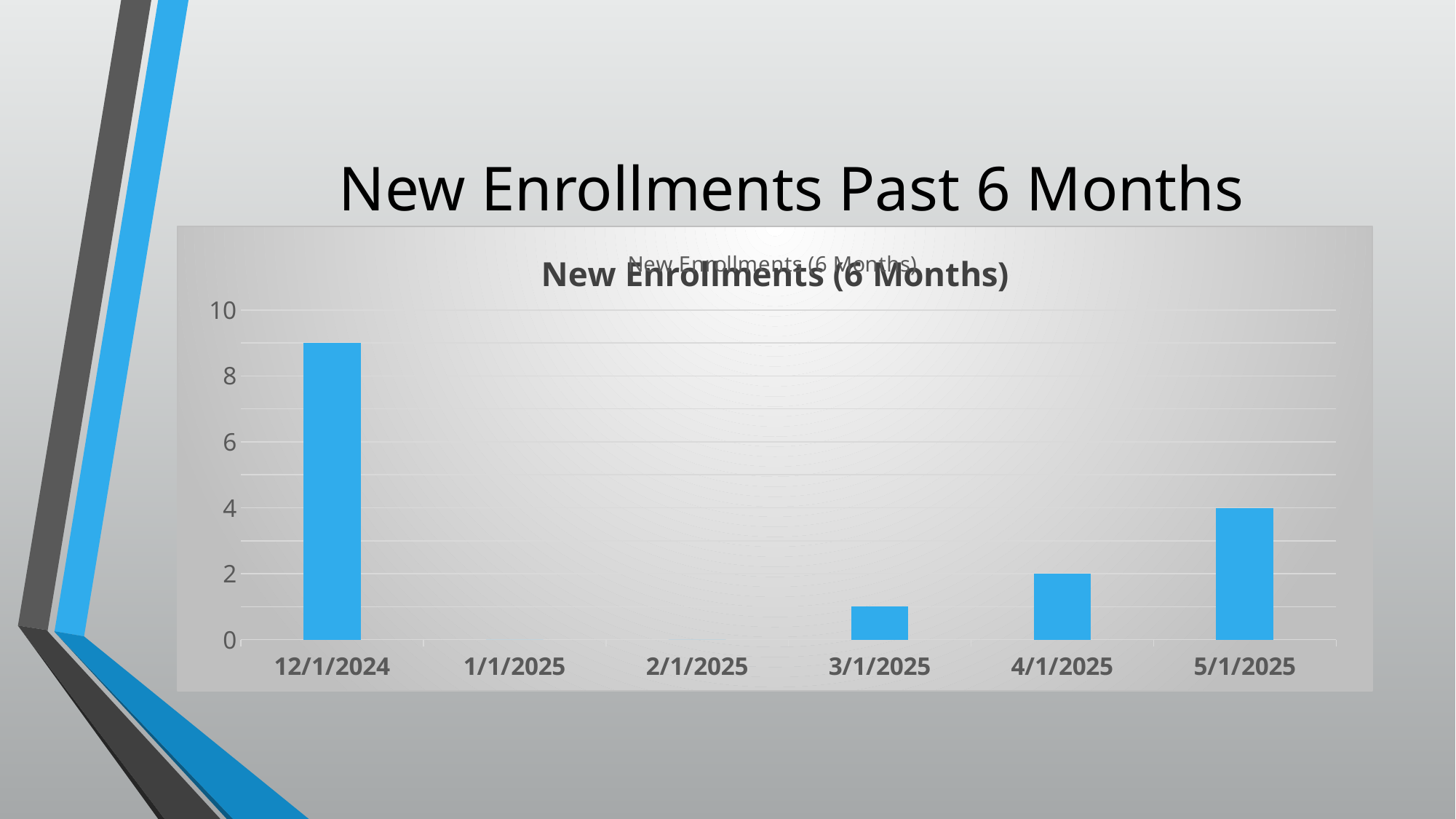
What is the value for 5/1/2025? 4 What is the title of the chart? New Enrollments (6 Months) What type of chart is shown on the slide? bar chart Which month has the highest number of new enrollments? 12/1/2024 How many months (categories) are shown on the x axis of the chart? 6 Is the value for 12/1/2024 greater or less than 8? greater What is the difference between the values for 5/1/2025 and 4/1/2025? 2 Do the values rise or fall from 3/1/2025 to 5/1/2025? rise What is the value for 4/1/2025? 2 Which is larger, the value for 5/1/2025 or the value for 4/1/2025? 5/1/2025 What is the value for 1/1/2025? 0 Is the value for 3/1/2025 greater or less than 2? less